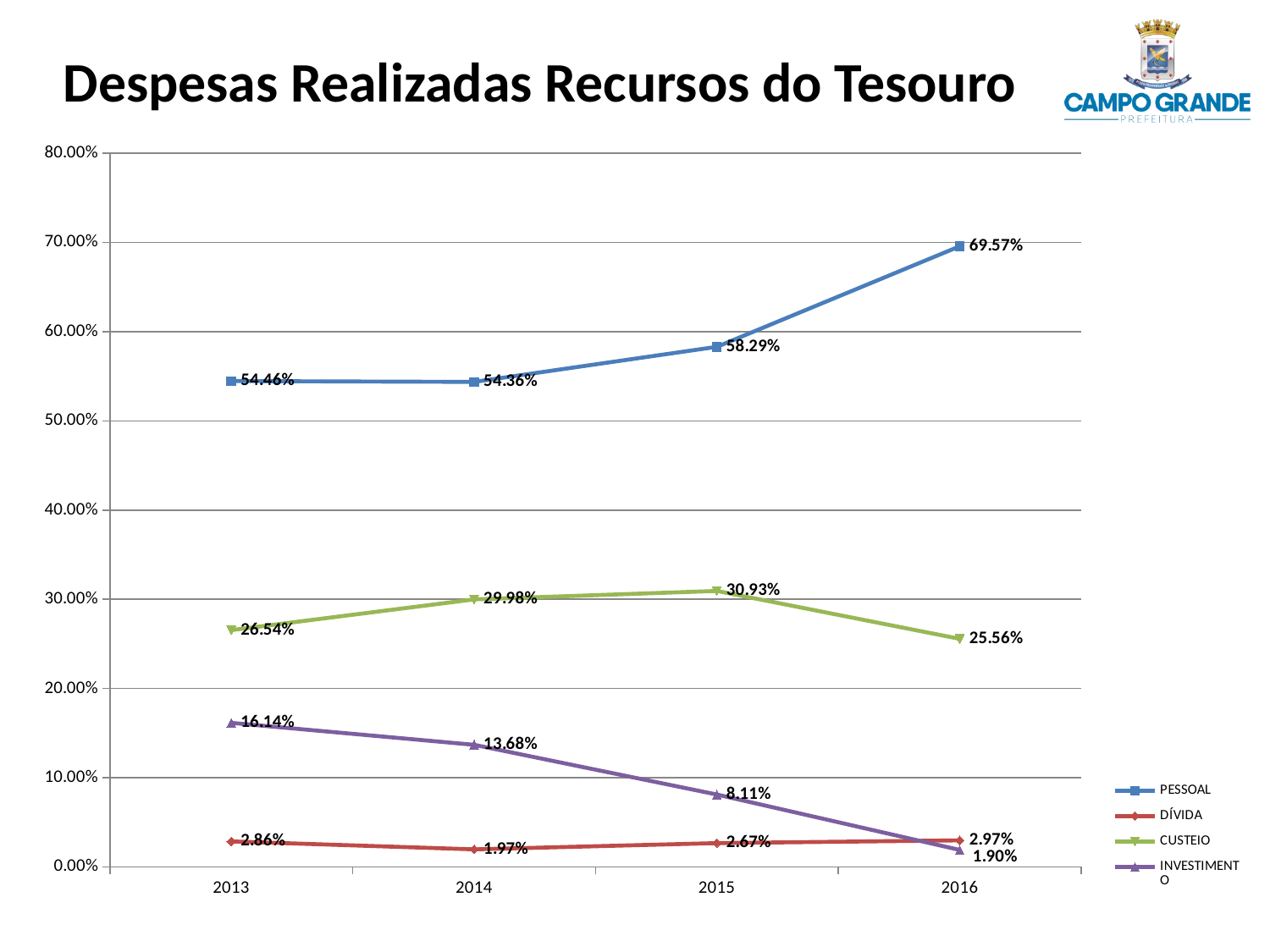
What is the difference between the PESSOAL values in 2016 and 2015? 11.28% How many years are shown on the x axis? 4 Which is larger in 2016, DÍVIDA or INVESTIMENTO? DÍVIDA What is the value for PESSOAL in 2016? 69.57% In which year is the INVESTIMENTO value lowest? 2016 What is the value for DÍVIDA in 2013? 2.86% What type of chart is shown on the slide? line chart Does the INVESTIMENTO series rise or fall from 2013 to 2016? fall What is the value for INVESTIMENTO in 2014? 13.68% How many series does the legend list? 4 What is the value for CUSTEIO in 2015? 30.93% In which year is the PESSOAL value highest? 2016